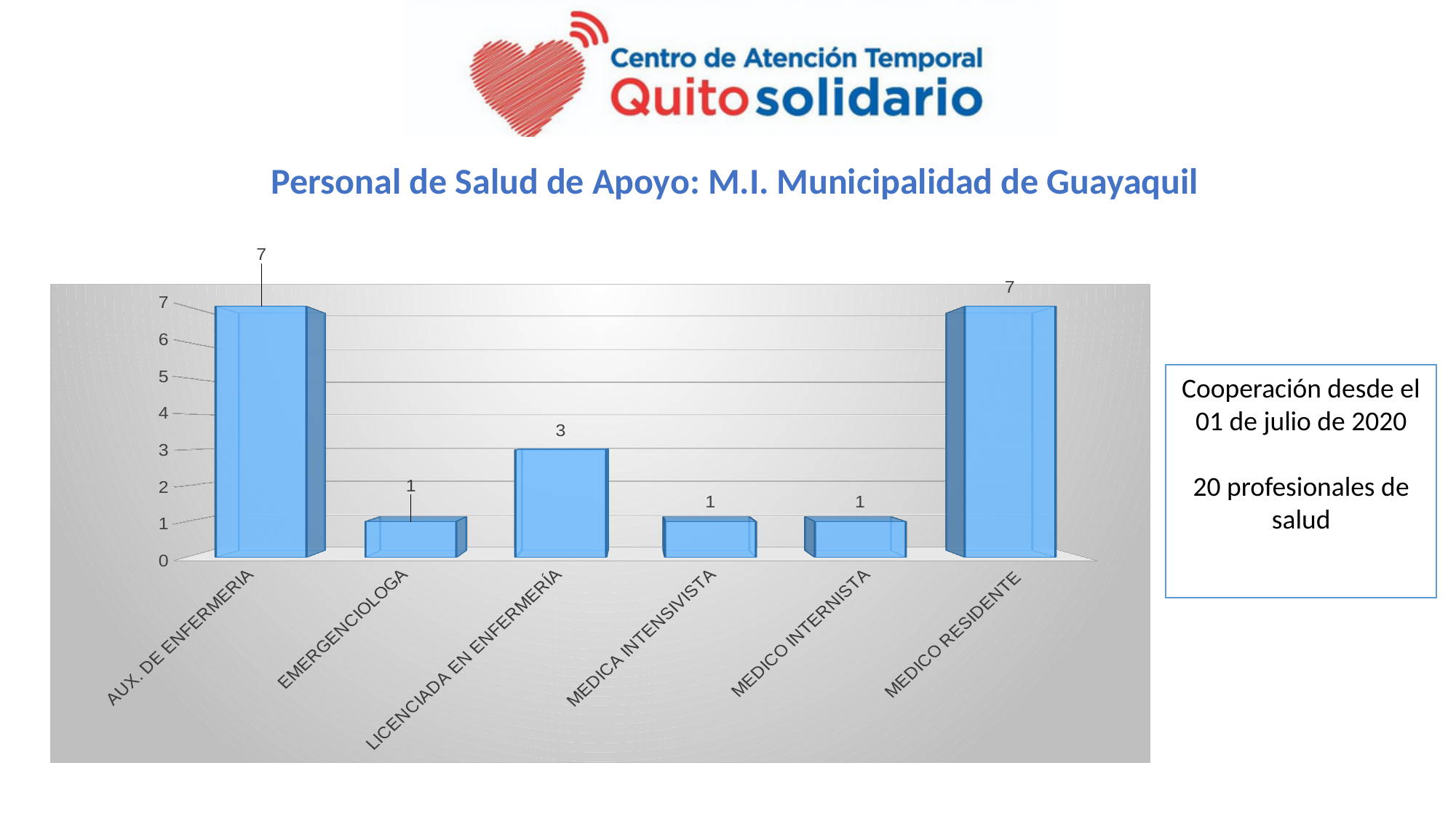
What is the value for MEDICA INTENSIVISTA? 1 What is the value for MEDICO RESIDENTE? 7 What is the title of the chart on the slide? Personal de Salud de Apoyo: M.I. Municipalidad de Guayaquil What is the value for AUX. DE ENFERMERIA? 7 What is the difference between the values for AUX. DE ENFERMERIA and LICENCIADA EN ENFERMERÍA? 4 Is the value for LICENCIADA EN ENFERMERÍA greater or less than 5? less Which is larger, the value for LICENCIADA EN ENFERMERÍA or the value for MEDICO INTERNISTA? LICENCIADA EN ENFERMERÍA Which two categories share the highest value in the chart? AUX. DE ENFERMERIA and MEDICO RESIDENTE What is the value for EMERGENCIOLOGA? 1 What is the value for LICENCIADA EN ENFERMERÍA? 3 How many categories are shown on the x axis of the chart? 6 What kind of chart is shown on the slide? bar chart